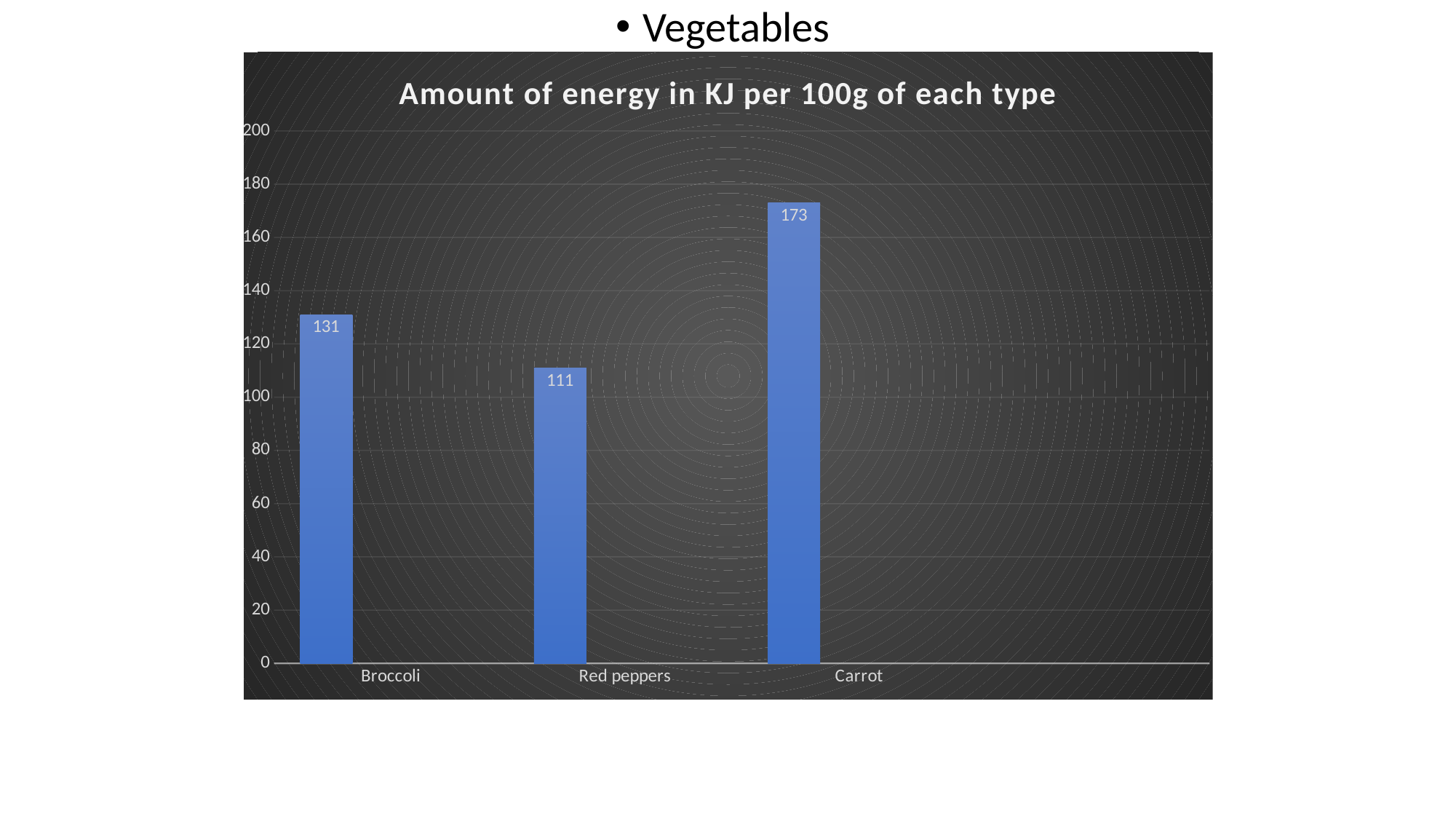
What is the value for Broccoli? 131 Is the value for Carrot greater or less than 160? greater What is the difference between the values for Carrot and Broccoli? 42 Which vegetable has the lowest amount of energy? Red peppers Which vegetable has the highest amount of energy? Carrot Which is larger, the value for Broccoli or the value for Red peppers? Broccoli How many vegetables are shown on the chart? 3 What is the title of the chart? Amount of energy in KJ per 100g of each type What is the difference between the values for Broccoli and Red peppers? 20 What kind of chart is shown on the slide? Bar chart What is the value for Carrot? 173 What is the value for Red peppers? 111